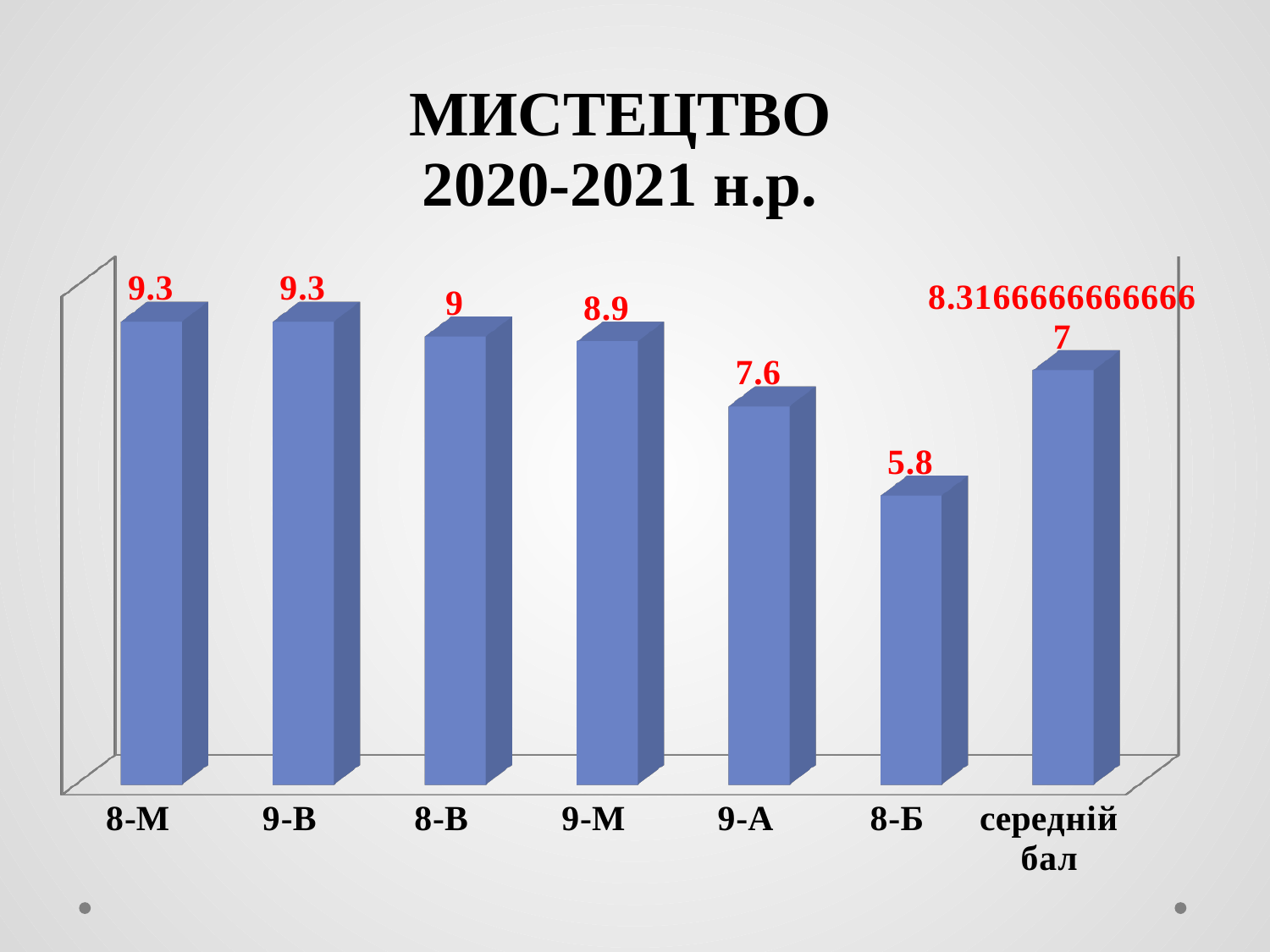
What is the difference between the values for 8-М and 8-Б? 3.5 What is the value for 9-А? 7.6 How many categories are shown on the x axis? 7 What is the title of the chart? МИСТЕЦТВО 2020-2021 н.р. What is the value for 9-М? 8.9 What is the value for 8-В? 9 What is the value shown for середній бал? 8.31666666666667 Which category has the lowest value? 8-Б Which is larger, the value for 8-В or the value for 9-А? 8-В What kind of chart is shown on the slide? bar chart What is the value for 8-Б? 5.8 What is the difference between the values for 9-М and 9-А? 1.3